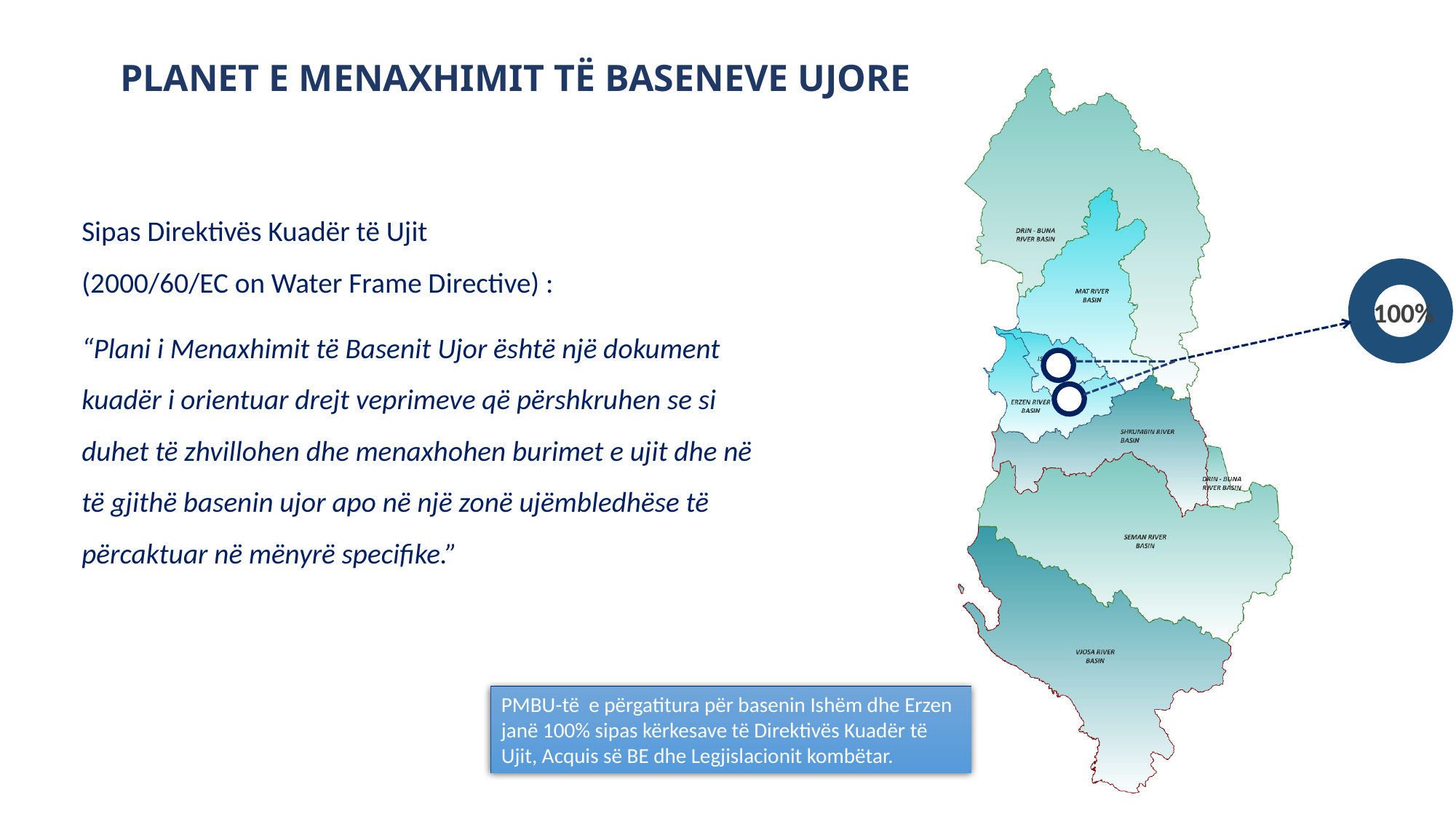
What value is printed in the centre of the doughnut chart? 100% Which two river basins on the map does the dashed line from the doughnut chart point to? Ishëm and Erzen How many slices does the doughnut chart show? 1 Is the value shown in the doughnut chart greater or less than 50%? greater What share of the doughnut chart is filled by the single slice? 100% What kind of chart is shown on the right side of the slide next to the map? doughnut chart What colour is the ring of the doughnut chart? dark blue